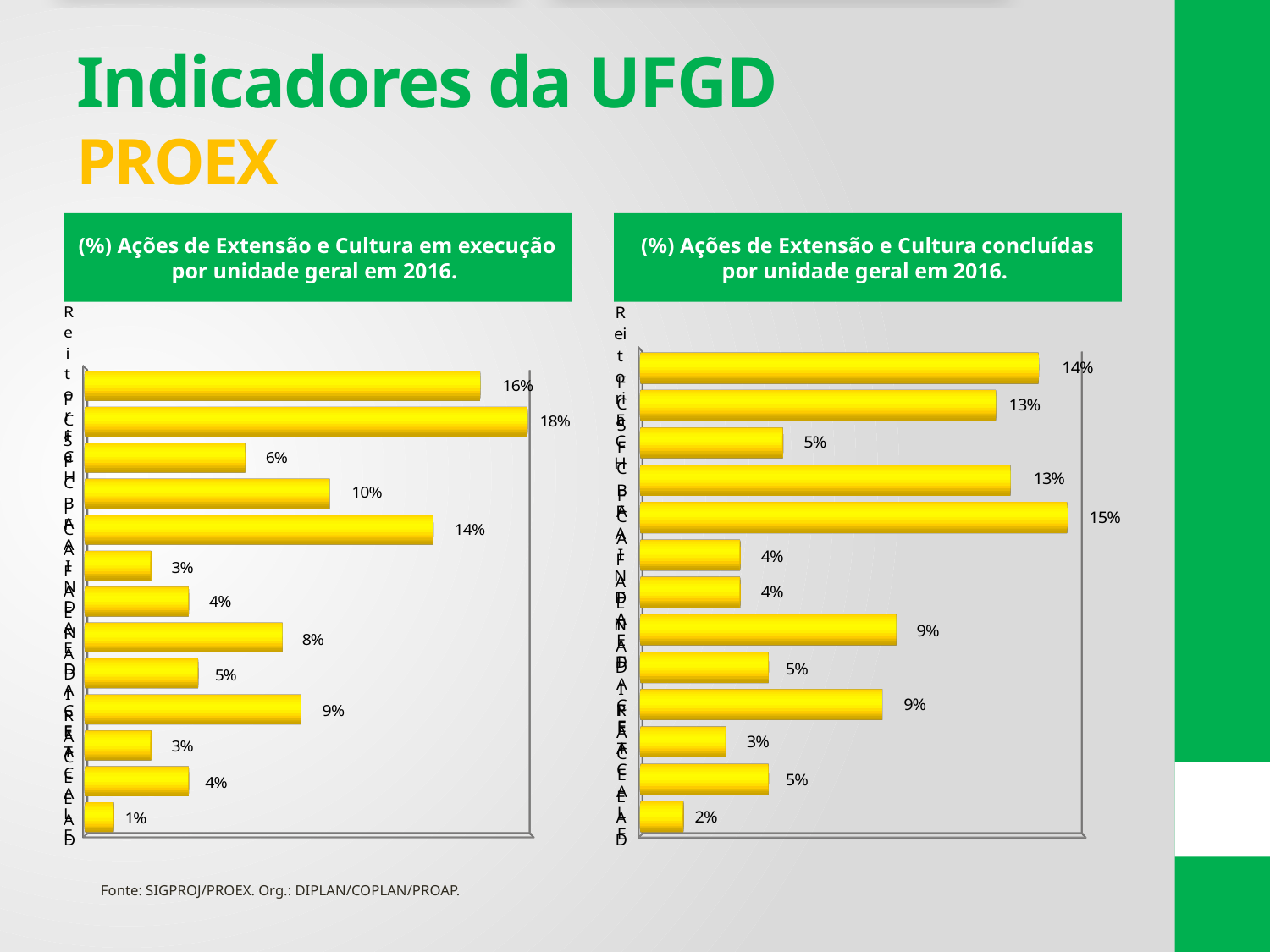
In the right chart (concluídas), what is the lowest value shown? 2% In the left chart (em execução), what is the value of the bottom bar? 1% In the right chart (concluídas), what is the highest value shown? 15% In the right chart (concluídas), what is the value of the topmost bar? 14% In the left chart (em execução), how many bars are plotted? 13 In the left chart (em execução), what is the highest value shown? 18% In the left chart (em execução), what is the lowest value shown? 1% In the left chart (em execução), what is the value of the topmost bar? 16% What type of chart is the left chart, '(%) Ações de Extensão e Cultura em execução por unidade geral em 2016'? bar chart In the left chart (em execução), what is the difference between the highest value (18%) and the lowest value (1%)? 17% In the right chart (concluídas), how many bars are plotted? 13 What is the title of the right chart? (%) Ações de Extensão e Cultura concluídas por unidade geral em 2016.